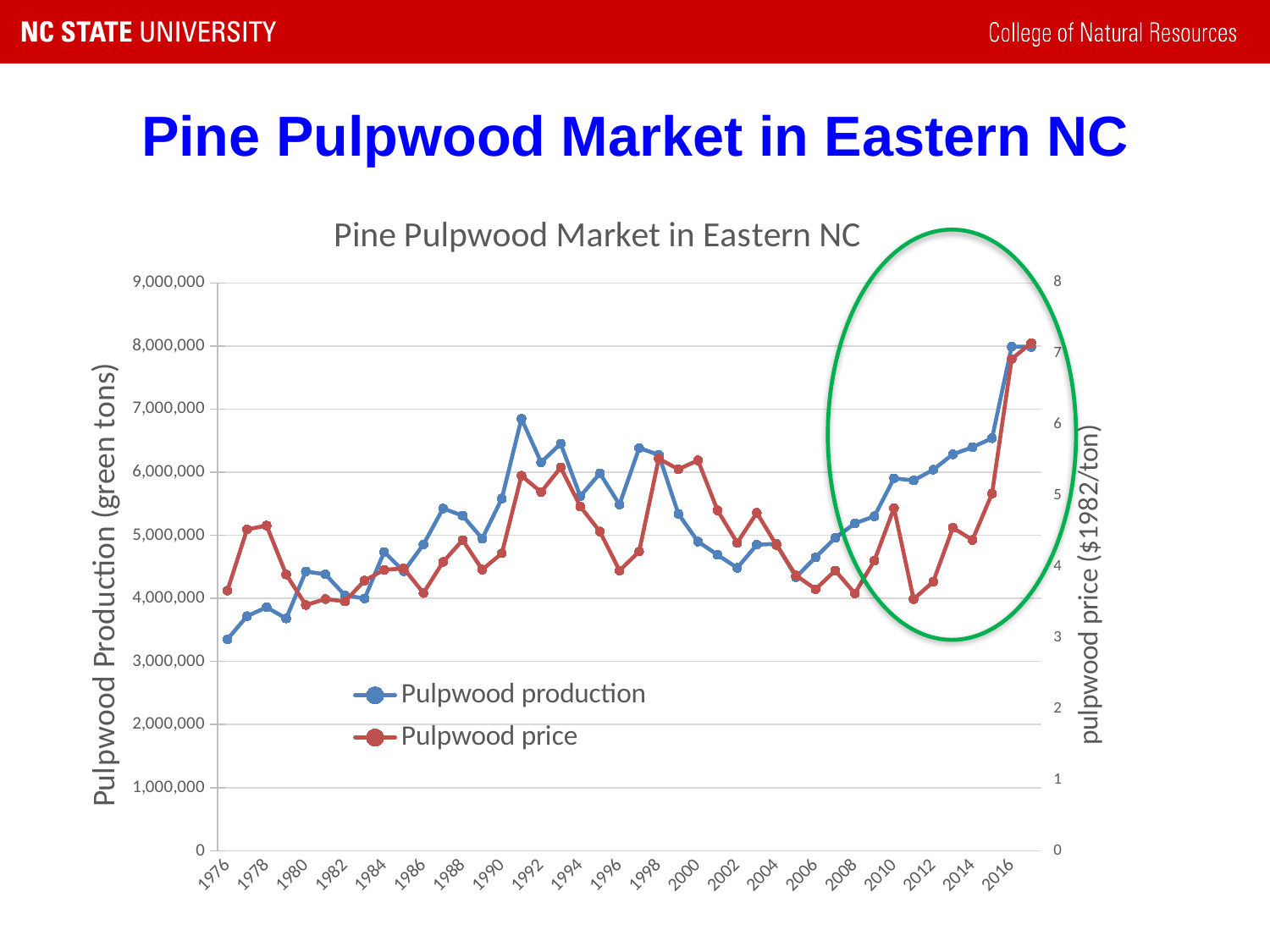
What kind of chart is shown on the slide? line chart Is the Pulpwood price value for 1978 greater or less than 4? greater Is the Pulpwood production value for 1976 greater or less than 4,000,000? less Is the Pulpwood production value for 1991 greater or less than 6,000,000? greater How many series does the chart's legend list? 2 In which year is Pulpwood production at its lowest? 1976 What is the title of the chart? Pine Pulpwood Market in Eastern NC What is the label of the right-hand vertical axis? pulpwood price ($1982/ton) Which is larger, Pulpwood production in 1991 or in 1976? 1991 Does Pulpwood production rise or fall between 2010 and 2016? rise